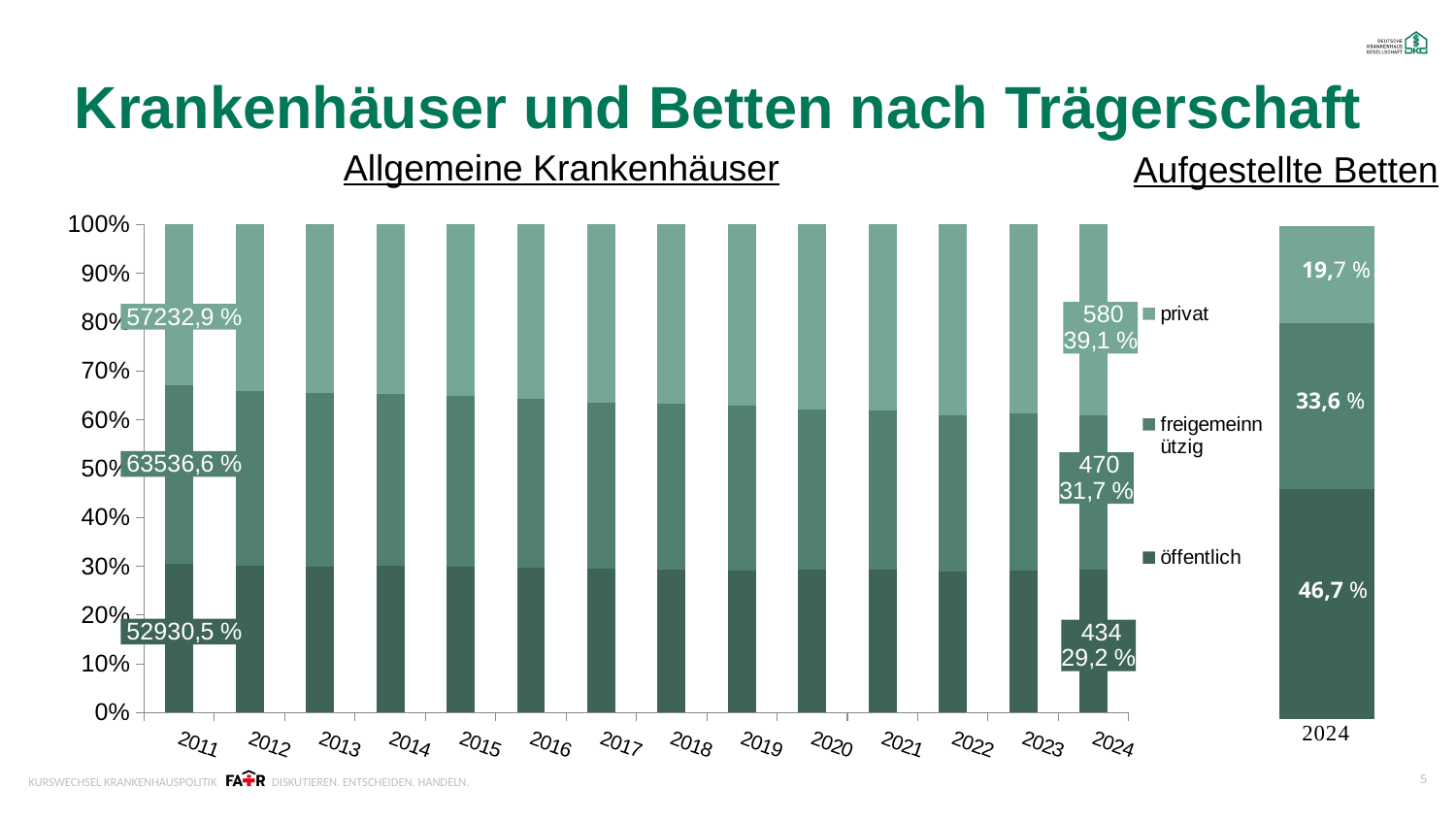
In the Allgemeine Krankenhäuser chart, which had more hospitals in 2011: freigemeinnützig or öffentlich? freigemeinnützig What kind of chart is the Allgemeine Krankenhäuser chart? Stacked bar chart In the Allgemeine Krankenhäuser chart, how many private (privat) hospitals are shown for 2011? 572 How many years are shown on the x axis of the Allgemeine Krankenhäuser chart? 14 In the Aufgestellte Betten chart, what share of beds is in public (öffentlich) hospitals in 2024? 46,7 % In the Allgemeine Krankenhäuser chart, what percentage share do private (privat) hospitals have in 2024? 39,1 % In the Allgemeine Krankenhäuser chart, by how many did the number of private (privat) hospitals change from 2011 (572) to 2024 (580)? 8 In the Allgemeine Krankenhäuser chart, how many public (öffentlich) hospitals are shown for 2024? 434 In the Allgemeine Krankenhäuser chart, does the share of private (privat) hospitals rise or fall from 2011 to 2024? Rise In the Aufgestellte Betten chart, which ownership type has the largest share of beds? öffentlich How many series does the legend of the Allgemeine Krankenhäuser chart list? 3 In the Aufgestellte Betten chart, which ownership type has the smallest share of beds? privat